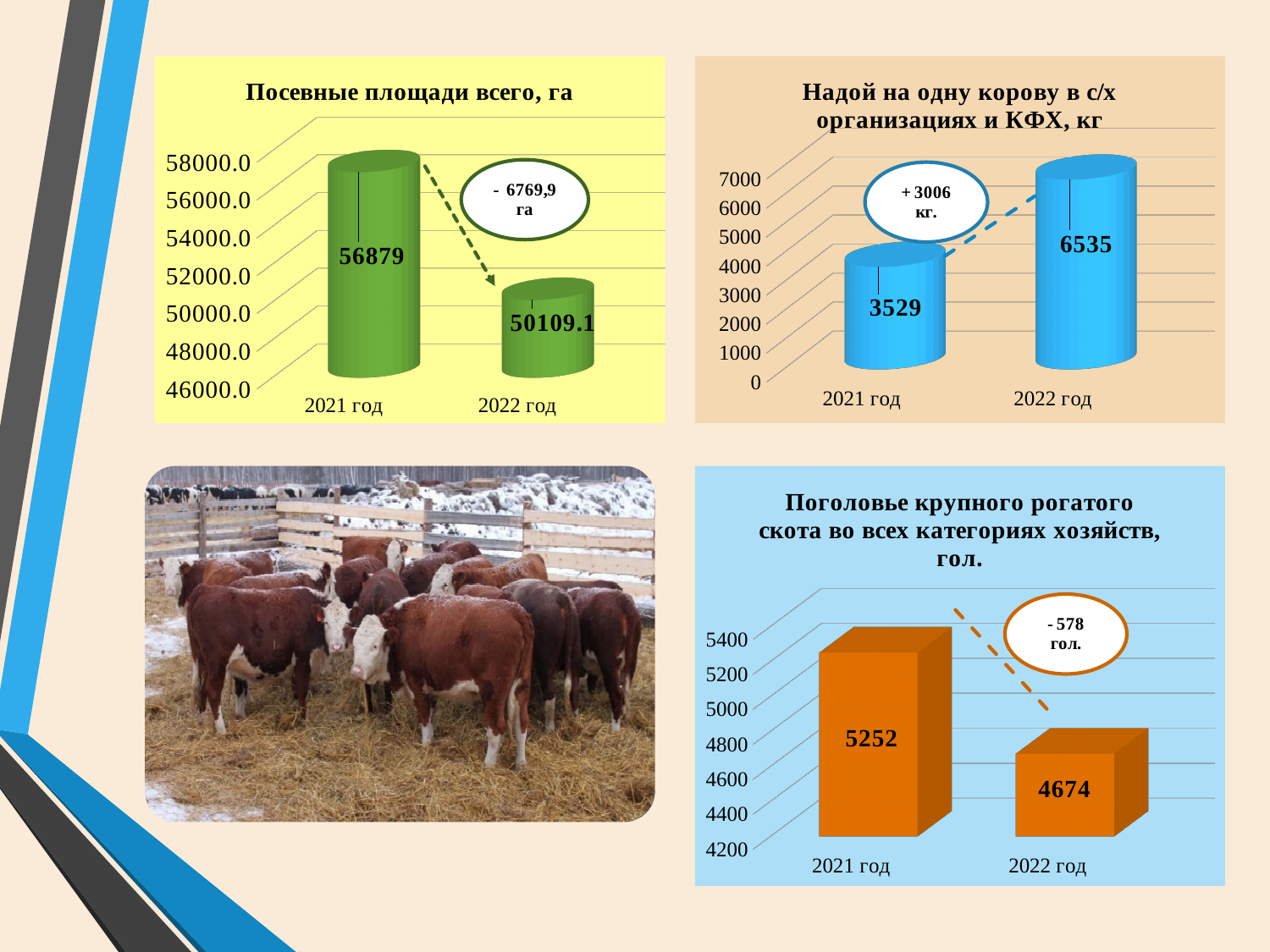
In the chart 'Надой на одну корову в с/х организациях и КФХ, кг', what is the value for 2022 год? 6535 In the chart 'Посевные площади всего, га', by how much did the value fall from 2021 год to 2022 год? 6769.9 In the chart 'Поголовье крупного рогатого скота во всех категориях хозяйств, гол.', what is the value for 2021 год? 5252 In the chart 'Посевные площади всего, га', what is the value for 2022 год? 50109.1 In the chart 'Надой на одну корову в с/х организациях и КФХ, кг', what is the value for 2021 год? 3529 In the chart 'Посевные площади всего, га', what is the value for 2021 год? 56879 How many charts are shown on the slide? 3 In the chart 'Поголовье крупного рогатого скота во всех категориях хозяйств, гол.', what is the value for 2022 год? 4674 In the chart 'Поголовье крупного рогатого скота во всех категориях хозяйств, гол.', by how much did the value decrease from 2021 год to 2022 год? 578 In the chart 'Посевные площади всего, га', do the values rise or fall from 2021 год to 2022 год? fall In the chart 'Надой на одну корову в с/х организациях и КФХ, кг', which year has the higher value? 2022 год In the chart 'Надой на одну корову в с/х организациях и КФХ, кг', what is the difference between the 2022 год and 2021 год values? 3006